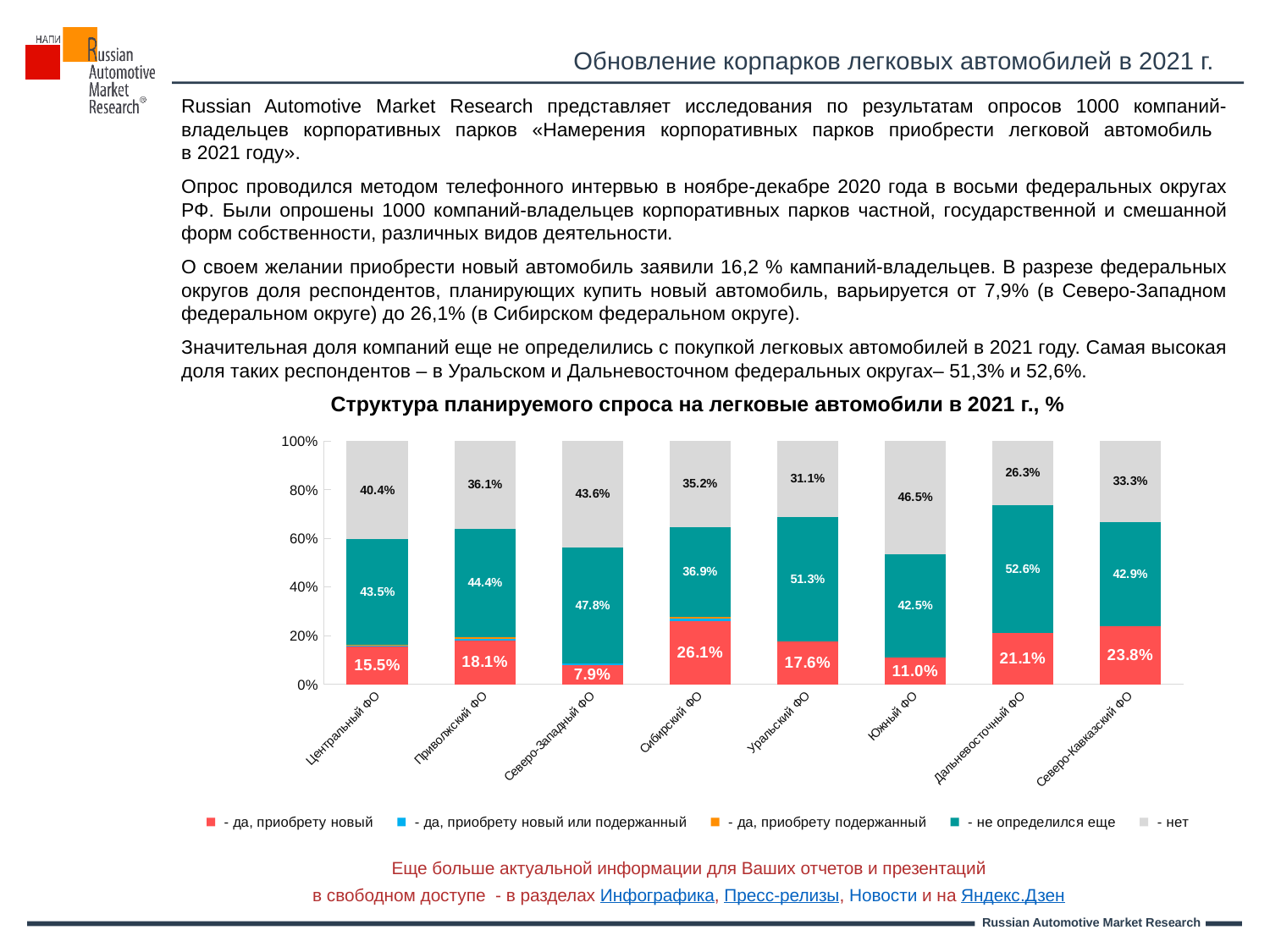
What type of chart is shown on the slide? Stacked bar chart What is the difference between the "да, приобрету новый" shares of Северо-Кавказский ФО and Центральный ФО? 8.3% Which federal district has the lowest share of respondents planning to buy a new car? Северо-Западный ФО Which federal district has the lowest share of "нет" respondents? Дальневосточный ФО How many federal districts are shown on the x axis of the chart? 8 Which federal district has the highest share of respondents planning to buy a new car? Сибирский ФО What is the title of the chart? Структура планируемого спроса на легковые автомобили в 2021 г., % Which is larger: the "нет" share in Центральный ФО or in Приволжский ФО? Центральный ФО What is the share of "не определился еще" respondents in Уральский ФО? 51.3% What percentage of companies in Сибирский ФО said they will buy a new car ("да, приобрету новый")? 26.1% How many series does the chart legend list? 5 What is the share of "нет" respondents in Южный ФО? 46.5%